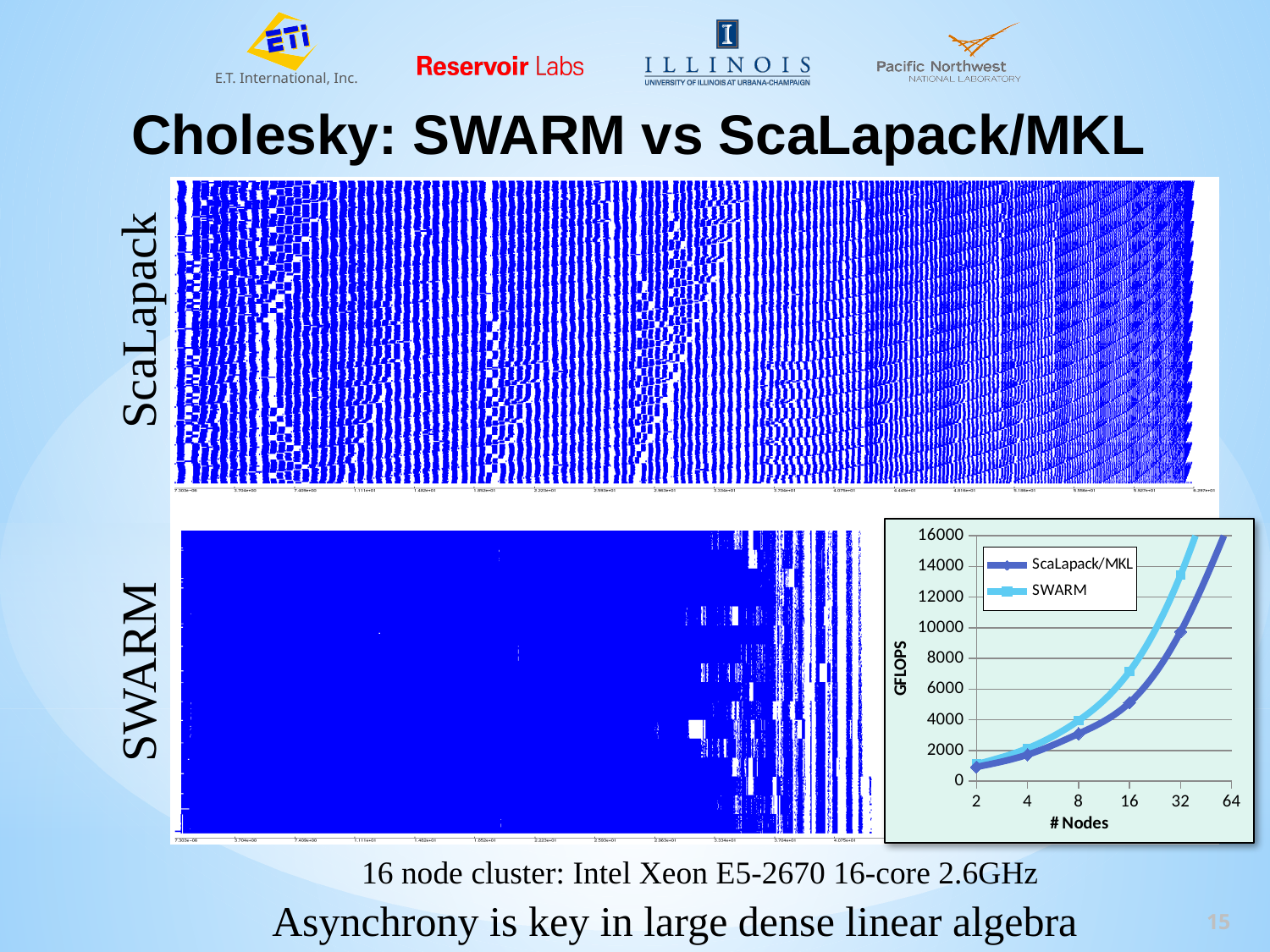
In the GFLOPS chart, is the SWARM value at 32 nodes greater or less than 12000? greater What kind of chart is the GFLOPS vs # Nodes chart on the right of the slide? line chart How many node counts are marked on the x axis of the GFLOPS chart? 6 In the GFLOPS chart, is the ScaLapack/MKL value at 8 nodes greater or less than 4000? less In the GFLOPS chart, do the GFLOPS values rise or fall as the number of nodes increases? rise In the GFLOPS chart, which series reaches higher GFLOPS at 32 nodes, ScaLapack/MKL or SWARM? SWARM What is the label of the x axis of the GFLOPS chart? # Nodes What is the label of the y axis of the GFLOPS chart? GFLOPS How many series does the legend of the GFLOPS chart list? 2 In the GFLOPS chart, is the ScaLapack/MKL value at 16 nodes greater or less than 6000? less